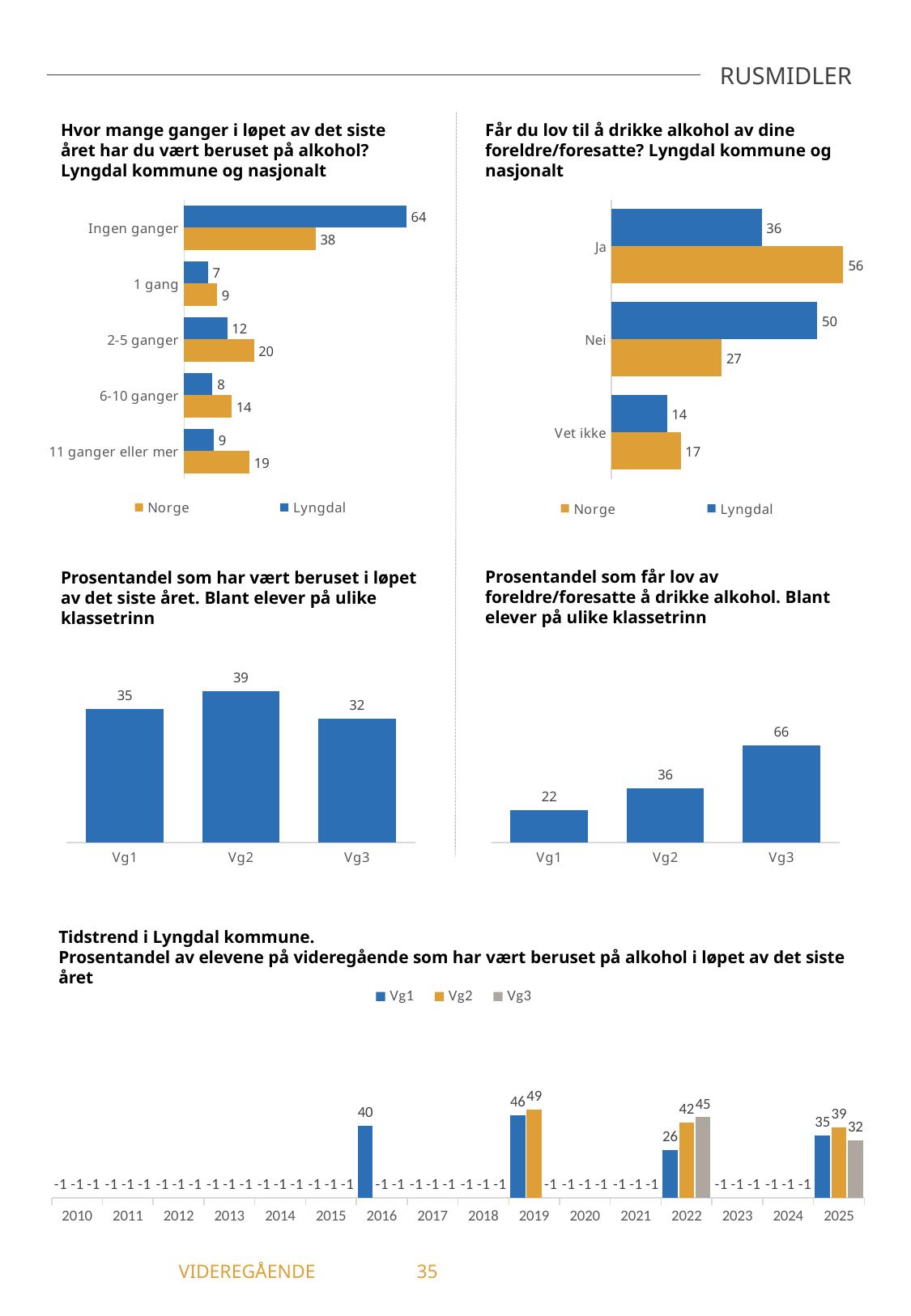
In the top-left chart (Hvor mange ganger ... beruset på alkohol), what is the difference between the Norge and Lyngdal values for '11 ganger eller mer'? 10 In the top-right chart (Får du lov til å drikke alkohol ...), what is the value for Norge in the 'Ja' category? 56 In the middle-left chart (Prosentandel som har vært beruset ... klassetrinn), what is the value for Vg3? 32 In the top-left chart (Hvor mange ganger ... beruset på alkohol), what is the value for Norge in the '2-5 ganger' category? 20 In the top-right chart (Får du lov til å drikke alkohol ...), which is larger for 'Nei': Lyngdal or Norge? Lyngdal In the middle-left chart (Prosentandel som har vært beruset ... klassetrinn), which class level has the highest value? Vg2 In the top-right chart (Får du lov til å drikke alkohol ...), how many series does the legend list? 2 What kind of chart is the bottom chart (Tidstrend i Lyngdal kommune)? bar chart In the middle-right chart (Prosentandel som får lov av foreldre/foresatte ... klassetrinn), do the values rise or fall from Vg1 to Vg3? rise In the middle-right chart (Prosentandel som får lov av foreldre/foresatte ... klassetrinn), what is the difference between Vg3 and Vg1? 44 In the top-left chart (Hvor mange ganger ... beruset på alkohol), what is the value for Lyngdal in the 'Ingen ganger' category? 64 In the bottom chart (Tidstrend i Lyngdal kommune), what is the value for Vg2 in 2022? 42